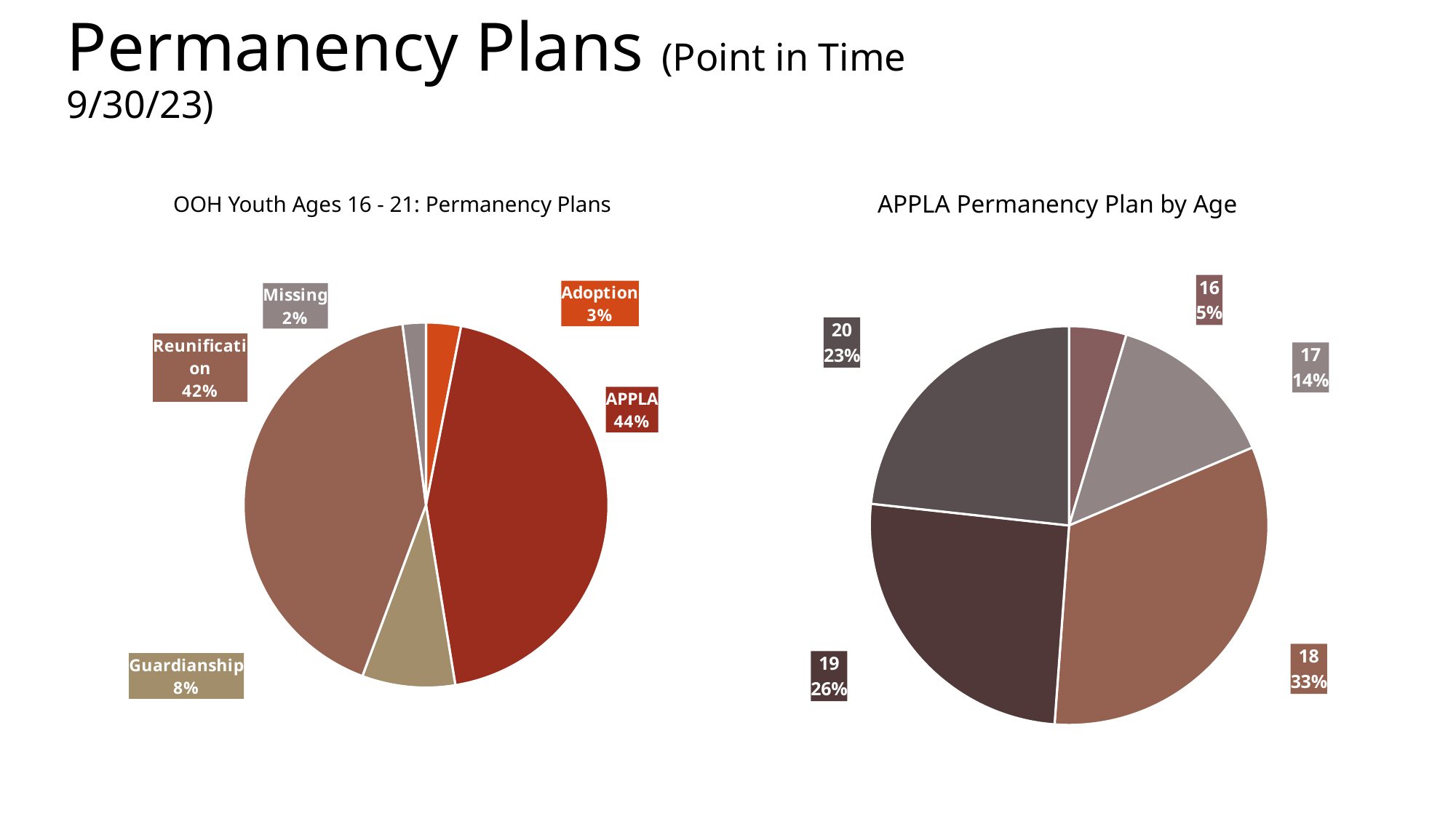
In the 'APPLA Permanency Plan by Age' chart, what share of the pie is age 18? 33% In the 'OOH Youth Ages 16 - 21: Permanency Plans' chart, which category has the smallest slice? Missing In the 'OOH Youth Ages 16 - 21: Permanency Plans' chart, what is the difference between the Reunification and Guardianship percentages? 34% What kind of chart is 'APPLA Permanency Plan by Age'? Pie chart In the 'APPLA Permanency Plan by Age' chart, which age has the smallest slice? 16 In the 'OOH Youth Ages 16 - 21: Permanency Plans' chart, what share of the pie is APPLA? 44% In the 'OOH Youth Ages 16 - 21: Permanency Plans' chart, which category has the largest slice? APPLA In the 'OOH Youth Ages 16 - 21: Permanency Plans' chart, what is the value for Guardianship? 8% In the 'APPLA Permanency Plan by Age' chart, what is the value for age 16? 5% In the 'APPLA Permanency Plan by Age' chart, which is larger, the slice for age 19 or the slice for age 20? 19 In the 'OOH Youth Ages 16 - 21: Permanency Plans' chart, how many categories are shown? 5 In the 'APPLA Permanency Plan by Age' chart, what is the difference between the percentages for age 18 and age 17? 19%